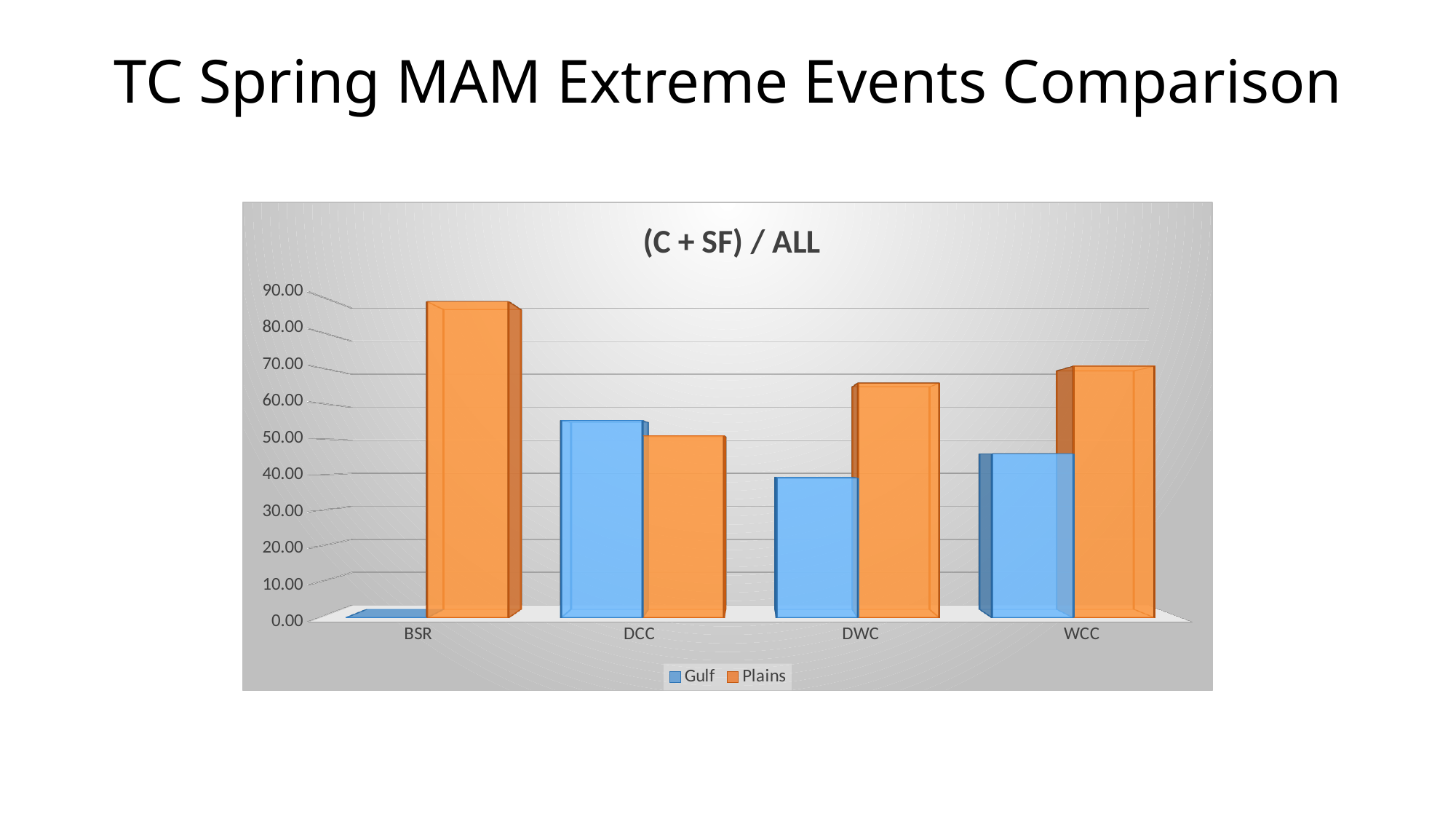
What is the title printed above the chart's plot area? (C + SF) / ALL Which category has the lowest Gulf value? BSR How many categories are shown on the x axis of the chart? 4 For DWC, which series has the larger value, Gulf or Plains? Plains Is the Gulf value for WCC greater or less than 50.00? less Is the Plains value for BSR greater or less than 80.00? greater Which series is shown in orange in the chart? Plains Which category has the highest Plains value? BSR How many series does the chart's legend list? 2 What kind of chart is shown on the slide? bar chart Which category has the highest Gulf value? DCC Which category has the lowest Plains value? DCC